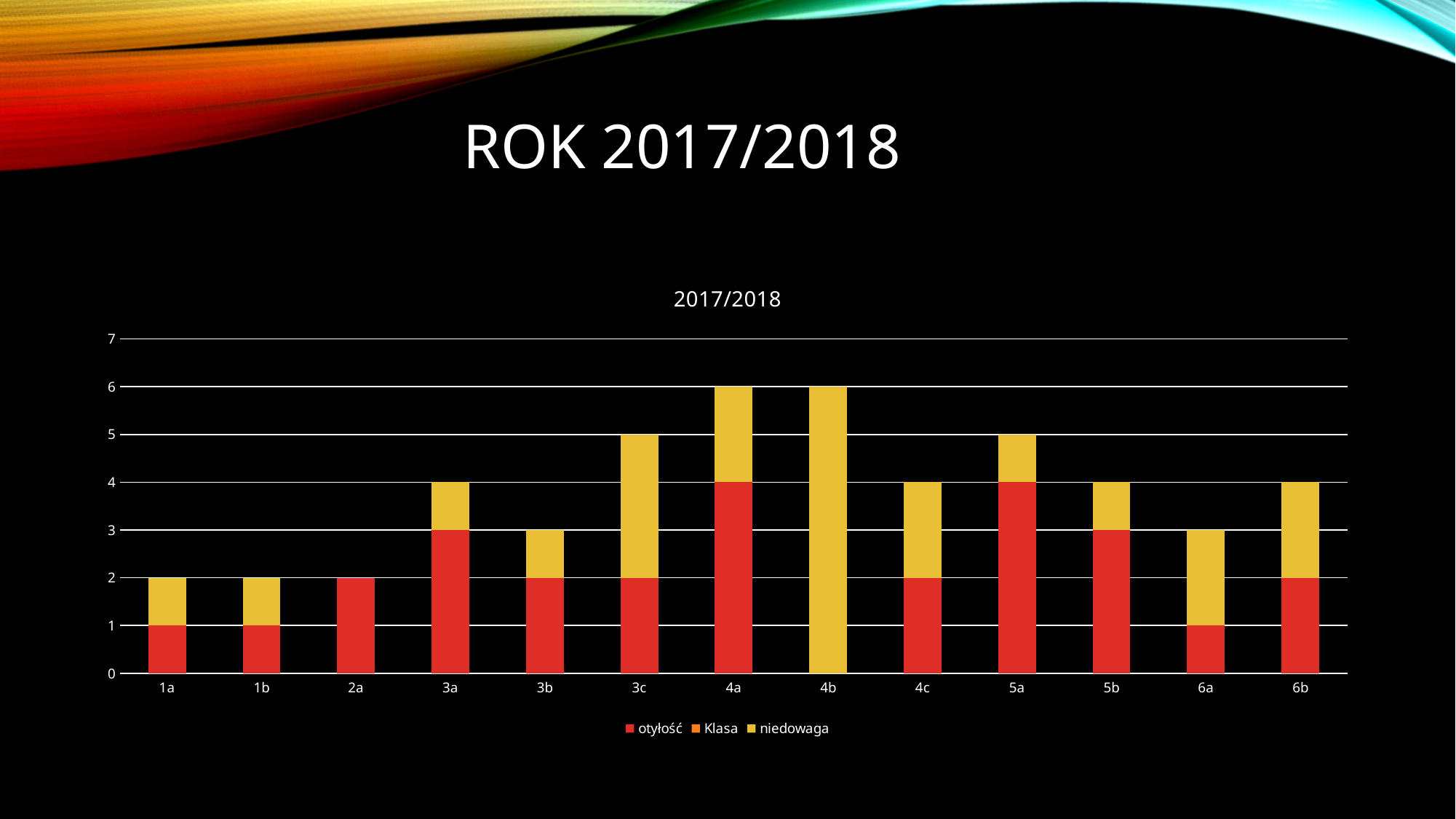
How many classes (categories) are shown on the x axis of the chart? 13 How many series does the chart legend list? 3 What is the niedowaga value for class 4b? 6 What kind of chart is shown on the slide? stacked bar chart Which class has the highest niedowaga value? 4b What is the total height of the stacked bar for class 3c? 5 Is the total stacked value for class 4a greater or less than 5? greater What is the otyłość value for class 4a? 4 Which is larger, the niedowaga value for class 3c or for class 5b? 3c What is the title shown above the chart? 2017/2018 What is the difference between the otyłość values for class 5a and class 6a? 3 What is the otyłość value for class 3a? 3